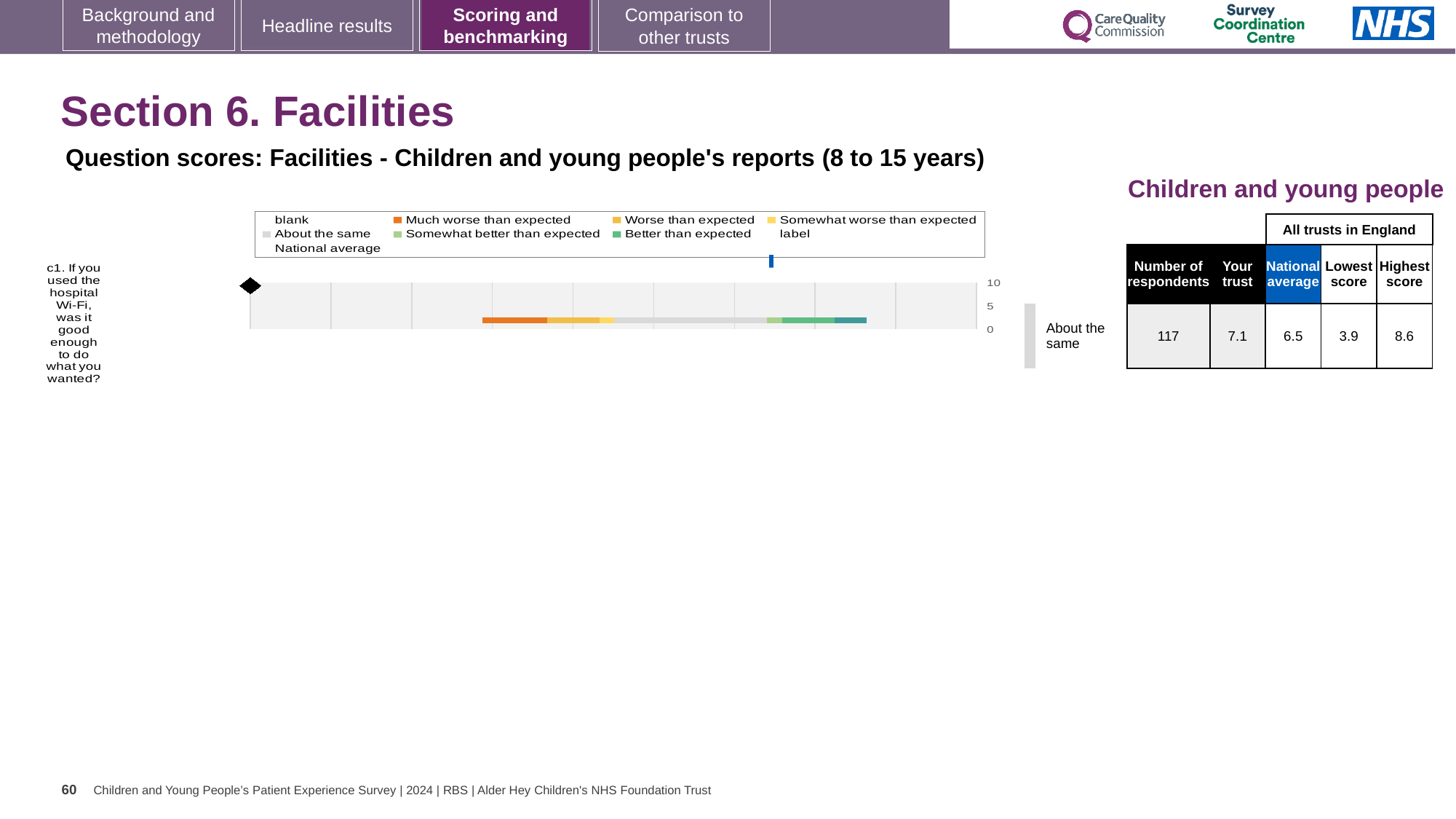
What is the difference between the highest score and the lowest score for question c1 in the table beside the chart? 4.7 According to the table beside the chart, what is the highest score among all trusts in England for question c1? 8.6 Which colour in the legend represents 'Much worse than expected'? orange According to the table beside the chart, what is the national average score for question c1? 6.5 What is the difference between the 'Your trust' score and the national average for question c1? 0.6 According to the table beside the chart, what is the lowest score among all trusts in England for question c1? 3.9 Which is larger for question c1: the 'Your trust' score or the national average? Your trust What kind of chart is shown on the slide? bar chart How many respondents answered question c1, according to the table beside the chart? 117 According to the table beside the chart, what is the 'Your trust' score for question c1? 7.1 How many survey questions are plotted in the chart? 1 Which survey question is plotted in the chart? c1. If you used the hospital Wi-Fi, was it good enough to do what you wanted?